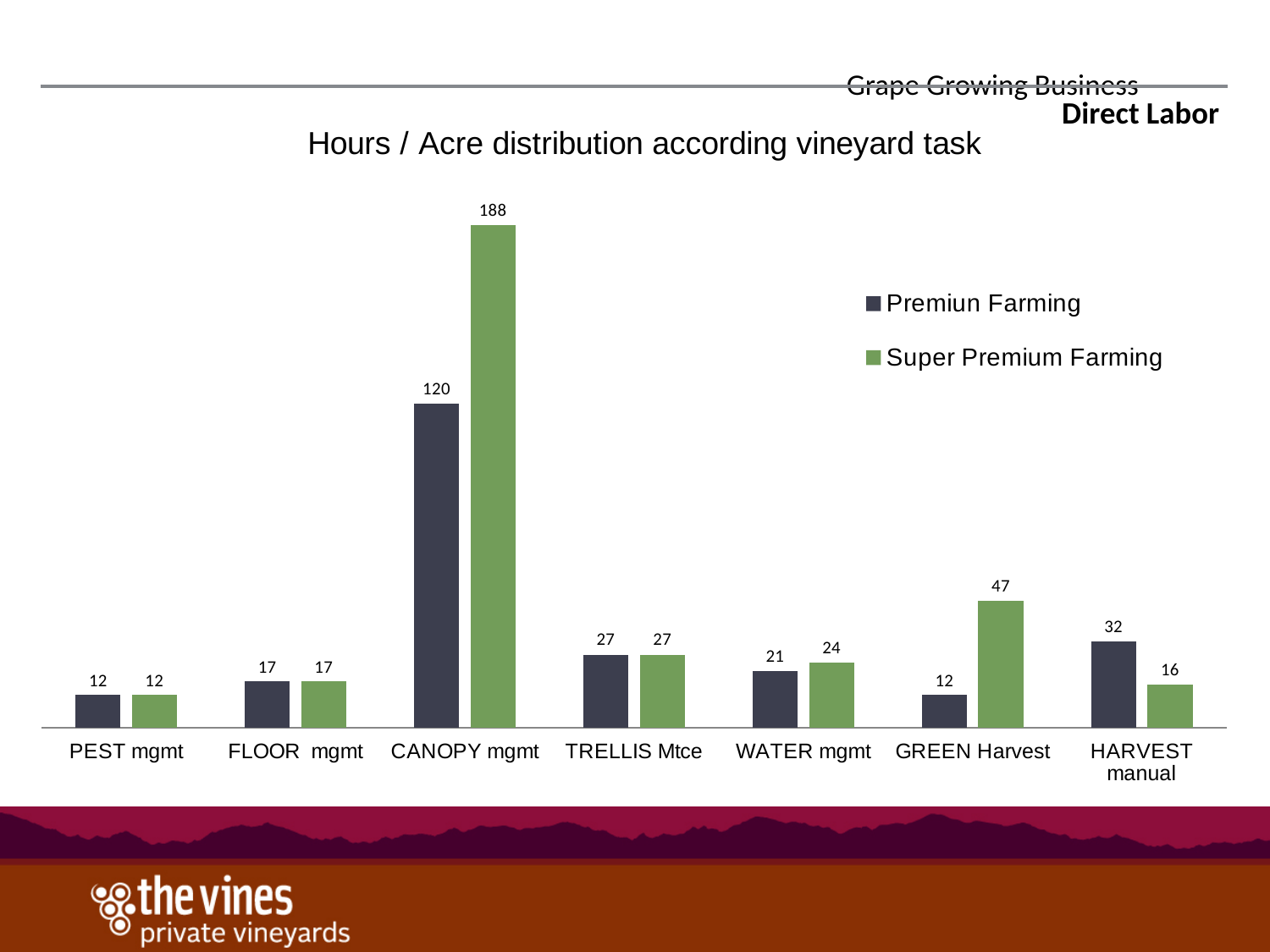
What kind of chart is shown on the slide? Bar chart What is the Super Premium Farming value for HARVEST manual? 16 For HARVEST manual, which series has the larger value, Premiun Farming or Super Premium Farming? Premiun Farming How many series does the legend list? 2 What is the difference between the Super Premium Farming and Premiun Farming values for CANOPY mgmt? 68 What is the Premiun Farming value for CANOPY mgmt? 120 Which vineyard task has the highest Super Premium Farming value? CANOPY mgmt What is the difference between the Super Premium Farming and Premiun Farming values for GREEN Harvest? 35 Which vineyard task has the lowest Premiun Farming value? PEST mgmt and GREEN Harvest (both 12) How many vineyard task categories are shown on the x axis? 7 What is the title of the chart? Hours / Acre distribution according vineyard task What is the Super Premium Farming value for GREEN Harvest? 47